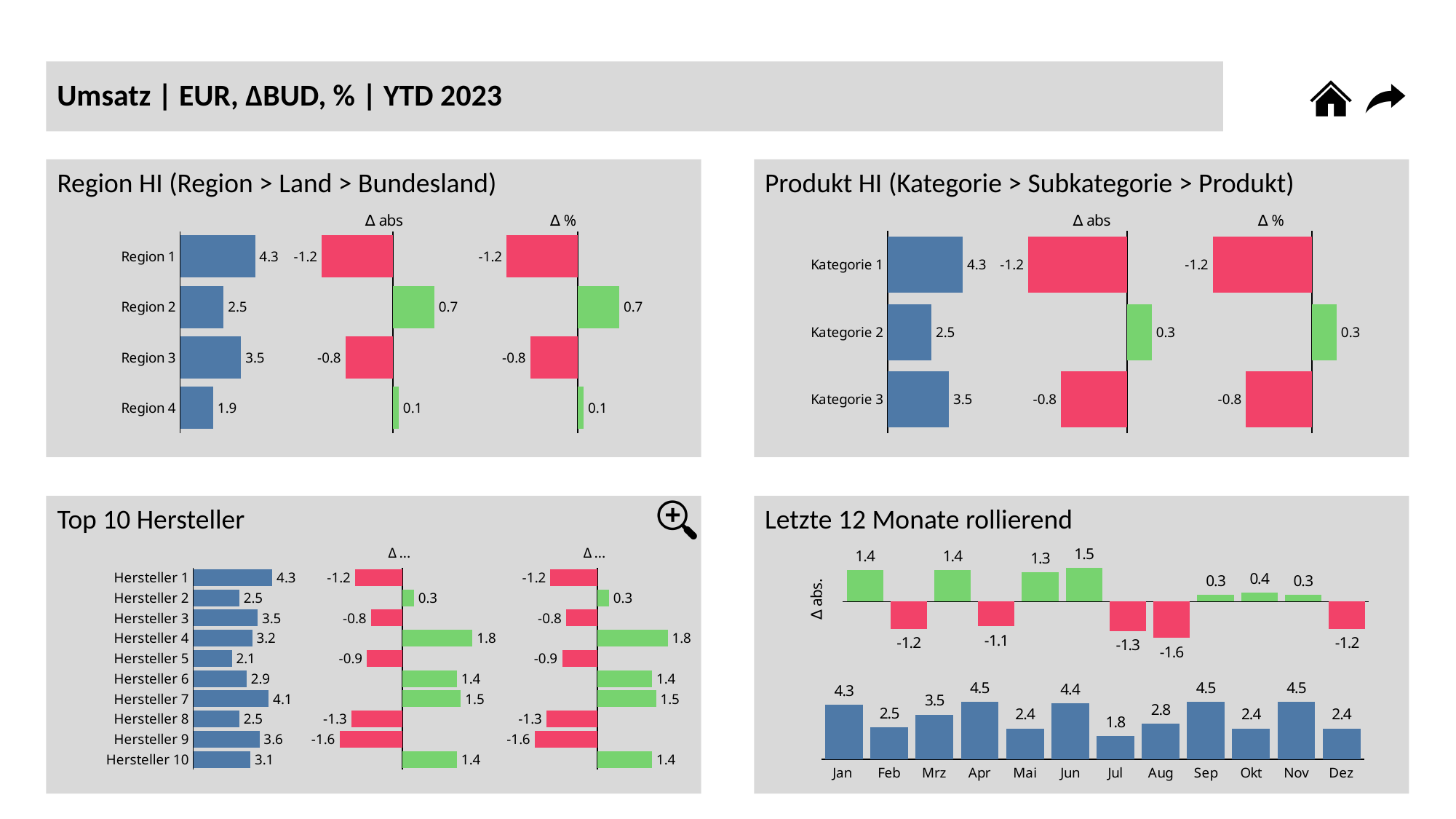
In the 'Letzte 12 Monate rollierend' chart, which month has the lowest value in the bottom bar chart? Jul In the 'Top 10 Hersteller' chart, which is larger, the value for Hersteller 4 or Hersteller 9? Hersteller 9 In the 'Region HI' chart, what is the value for Region 3? 3.5 In the 'Produkt HI' chart, how many categories are shown? 3 In the 'Top 10 Hersteller' chart, what is the value for Hersteller 7? 4.1 In the 'Letzte 12 Monate rollierend' chart, which month has the highest Δ abs value? Jun In the 'Region HI' chart, what is the Δ abs value for Region 2? 0.7 In the 'Produkt HI' chart, what is the difference between the values for Kategorie 1 and Kategorie 2? 1.8 What type of chart is used in the 'Letzte 12 Monate rollierend' panel? Bar chart In the 'Top 10 Hersteller' chart, which Hersteller has the lowest value? Hersteller 5 In the 'Region HI' chart, which region has the lowest value? Region 4 In the 'Produkt HI' chart, what is the Δ % value for Kategorie 3? -0.8